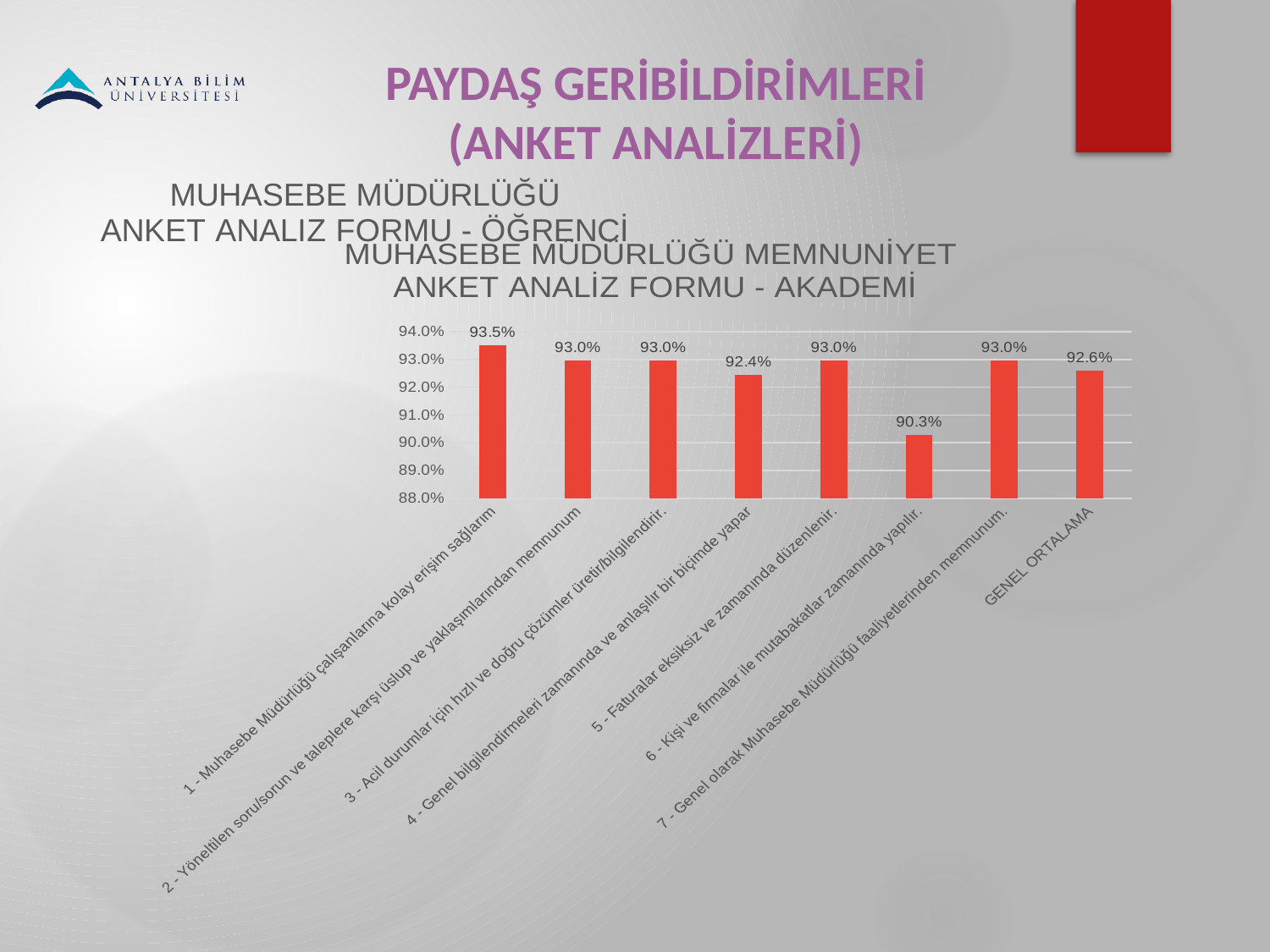
What is the value for "1 - Muhasebe Müdürlüğü çalışanlarına kolay erişim sağlarım"? 93.5% What kind of chart is shown on the slide? bar chart What is the value for "GENEL ORTALAMA"? 92.6% Which category has the highest value? 1 - Muhasebe Müdürlüğü çalışanlarına kolay erişim sağlarım What is the value for "4 - Genel bilgilendirmeleri zamanında ve anlaşılır bir biçimde yapar"? 92.4% What is the value for "6 - Kişi ve firmalar ile mutabakatlar zamanında yapılır."? 90.3% Which is larger: the value for "5 - Faturalar eksiksiz ve zamanında düzenlenir." or the value for "4 - Genel bilgilendirmeleri zamanında ve anlaşılır bir biçimde yapar"? 5 - Faturalar eksiksiz ve zamanında düzenlenir. How many bars (categories) does the chart show? 8 Which category has the lowest value? 6 - Kişi ve firmalar ile mutabakatlar zamanında yapılır. What is the difference between the value for category 1 (93.5%) and category 6 (90.3%)? 3.2% What is the title of the chart? MUHASEBE MÜDÜRLÜĞÜ MEMNUNİYET ANKET ANALİZ FORMU - AKADEMİ Is the value for "6 - Kişi ve firmalar ile mutabakatlar zamanında yapılır." greater or less than 91.0%? less